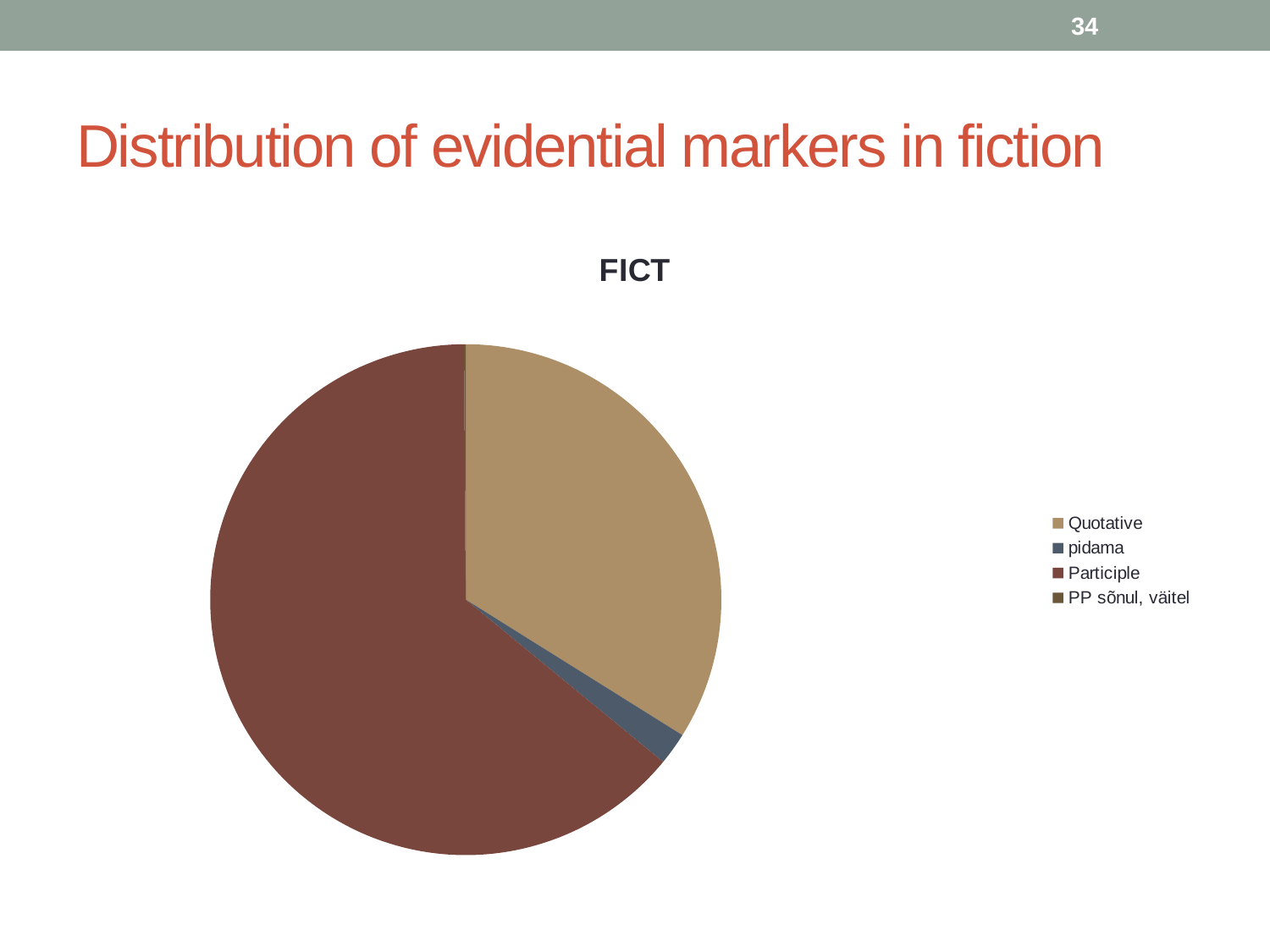
Which is larger in the pie chart, the pidama slice or the Participle slice? Participle What kind of chart is shown on the slide? pie chart Which is larger in the pie chart, the Quotative slice or the pidama slice? Quotative Which legend entry is shown in the tan colour in the pie chart? Quotative Which category has the largest slice of the pie chart? Participle How many entries does the legend of the pie chart list? 4 Which is larger in the pie chart, the Quotative slice or the Participle slice? Participle Which category is listed last in the legend of the pie chart? PP sõnul, väitel What is the title of the pie chart? FICT